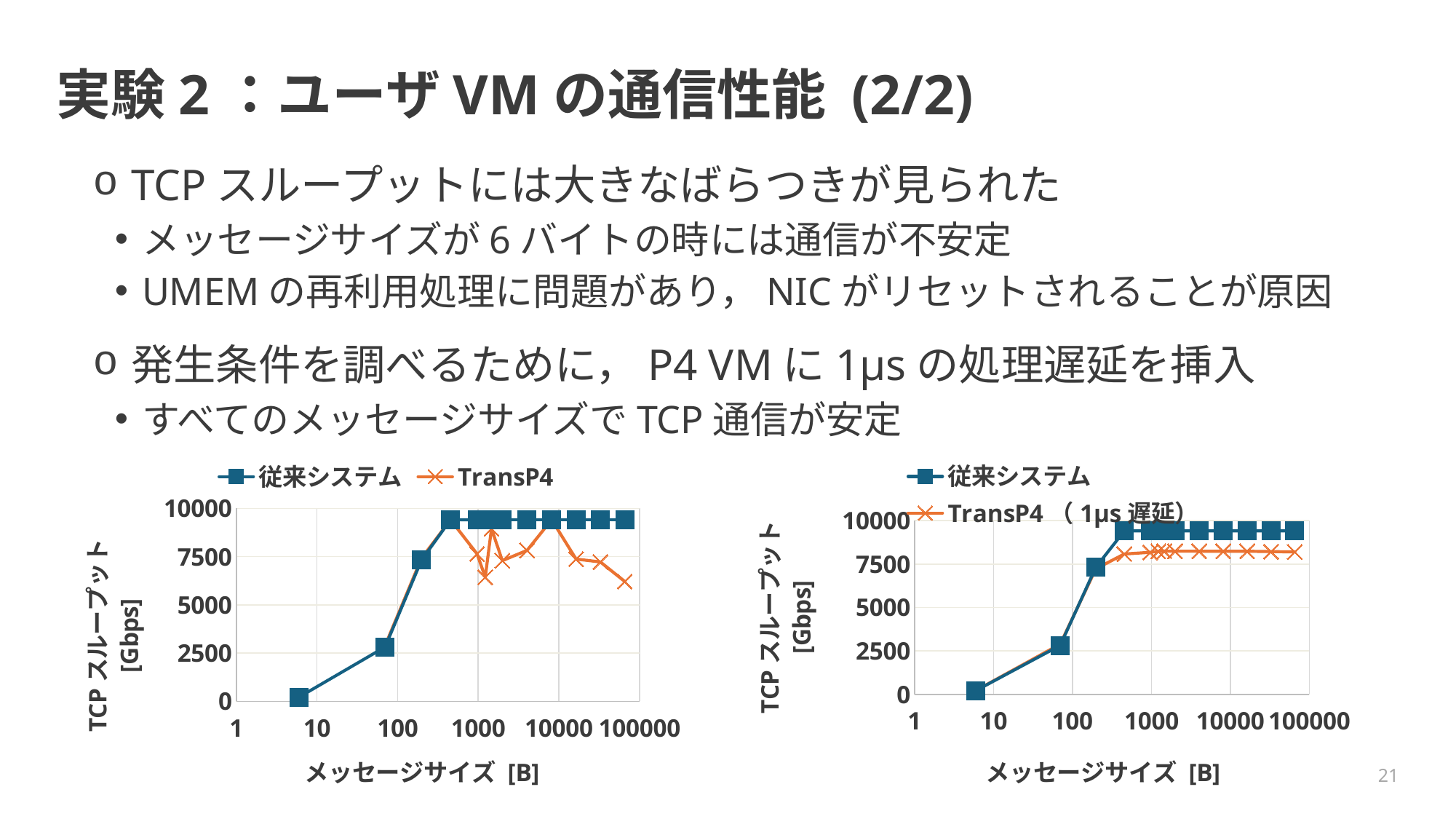
What kind of chart is the left chart on the slide? line chart In the right chart, is the value for TransP4（1μs 遅延） at a message size of 100000 B greater or less than 7500? greater In the left chart, at a message size of 100000 B, which series has the higher TCP throughput, 従来システム or TransP4? 従来システム How many series does the legend of the right chart list? 2 In the right chart, what is the name of the second series in the legend? TransP4（1μs 遅延） What is the label of the x axis of the left chart? メッセージサイズ [B] In the right chart, at a message size of 10000 B, which series has the higher TCP throughput, 従来システム or TransP4（1μs 遅延）? 従来システム How many series does the legend of the left chart list? 2 In the left chart, is the value for TransP4 at a message size of 100000 B greater or less than 7500? less In the right chart, do the values for 従来システム rise or fall as the message size increases from 1 B to 1000 B? rise In the right chart, is the value for 従来システム at the smallest message size greater or less than 2500? less